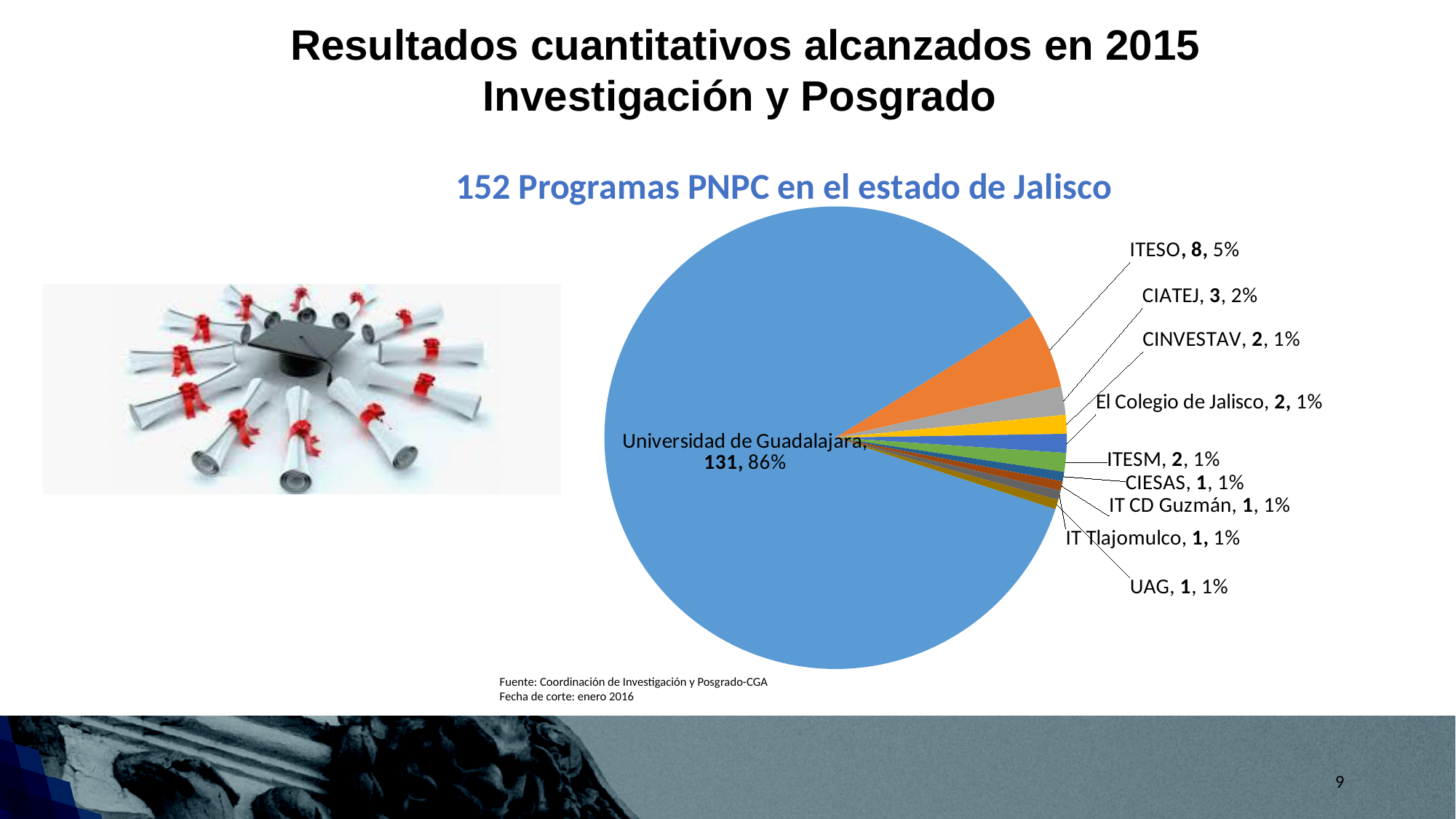
How many PNPC programs does CIATEJ have? 3 How many PNPC programs does Universidad de Guadalajara have? 131 Which has more PNPC programs, CIATEJ or CINVESTAV? CIATEJ How many PNPC programs does UAG have? 1 How many institutions (slices) are shown in the pie chart? 10 What share of the pie does Universidad de Guadalajara represent? 86% What share of the pie does ITESO represent? 5% What is the difference between the number of programs at Universidad de Guadalajara and ITESO? 123 How many PNPC programs does ITESO have? 8 What is the title of the chart? 152 Programas PNPC en el estado de Jalisco Which institution has the largest slice of the pie? Universidad de Guadalajara What type of chart is shown on the slide? pie chart